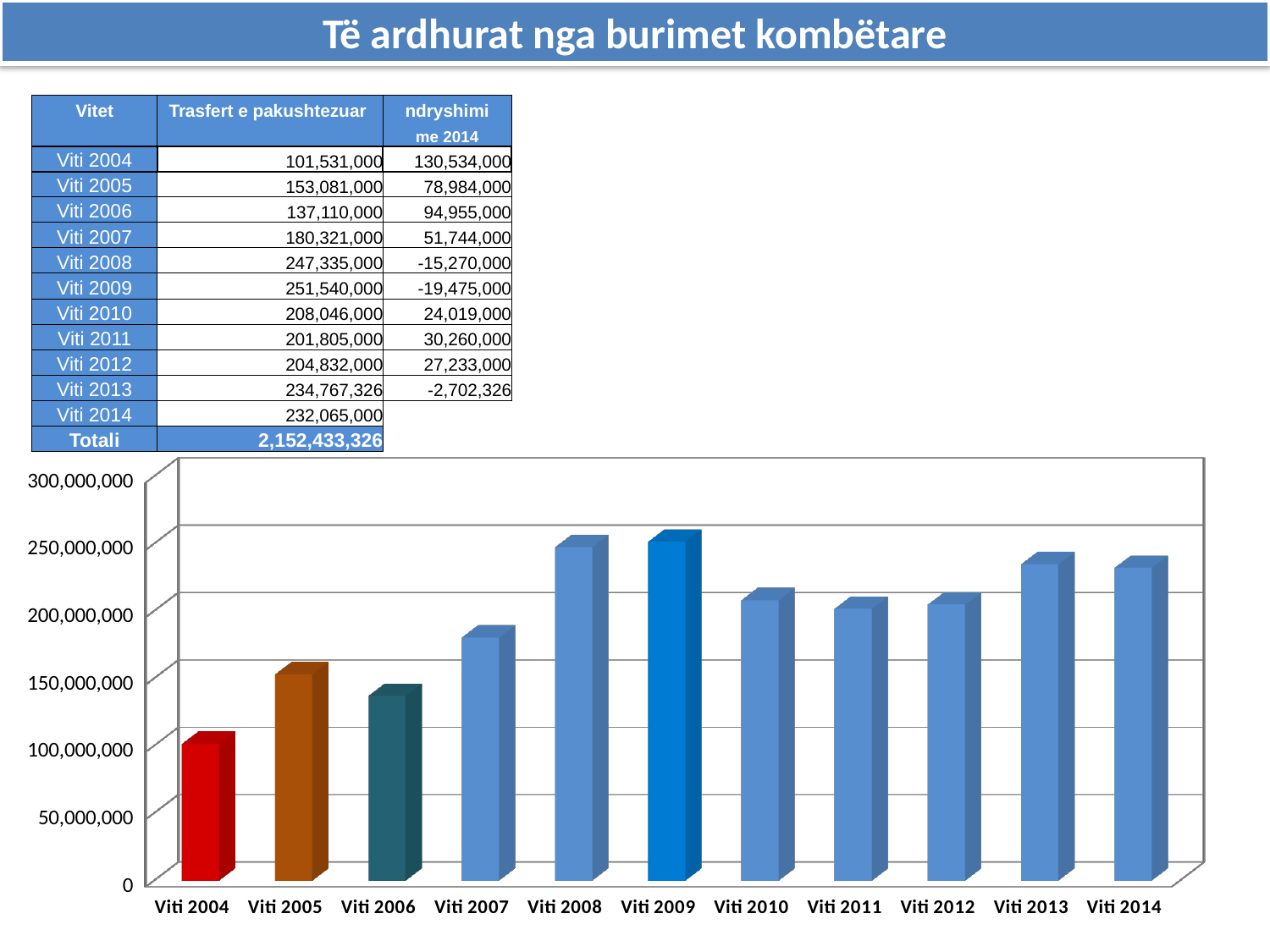
What is the value for Viti 2004 as printed in the table? 101,531,000 Is the value for Viti 2006 greater or less than 150,000,000? less What is the difference between the values for Viti 2005 and Viti 2004, using the figures printed in the table? 51,550,000 Which year has the lowest bar on the chart? Viti 2004 Is the value for Viti 2007 greater or less than 150,000,000? greater What is the value for Viti 2009 as printed in the table? 251,540,000 What kind of chart is shown on the slide? bar chart Which is larger, the value for Viti 2005 or the value for Viti 2006? Viti 2005 How many years (categories) are plotted on the chart? 11 Do the values rise or fall from Viti 2004 to Viti 2009? rise Which year has the highest value on the chart? Viti 2009 Is the value for Viti 2013 greater or less than 200,000,000? greater